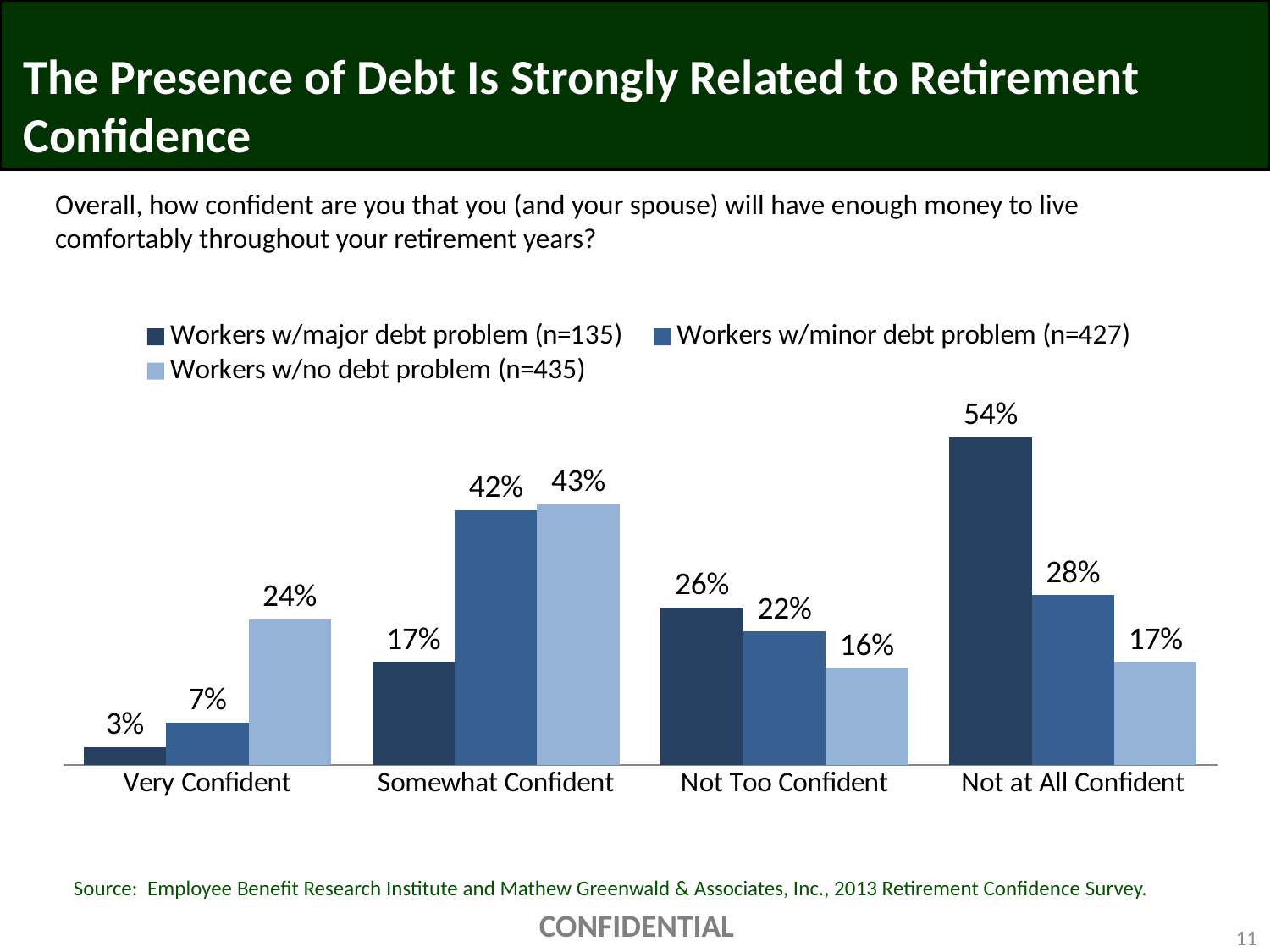
What is the difference between workers with a major debt problem and workers with no debt problem in the Not at All Confident category? 37% Do the values for workers with a major debt problem rise or fall from Very Confident to Not at All Confident? Rise How many series does the legend list? 3 Which is larger in the Not Too Confident category: workers with a major debt problem or workers with a minor debt problem? Workers w/major debt problem What kind of chart is shown on the slide? Bar chart What percentage of workers with a major debt problem are Not at All Confident? 54% What percentage of workers with a minor debt problem are Somewhat Confident? 42% Which category has the lowest value for workers with no debt problem? Not Too Confident What is the sample size (n) for workers with a minor debt problem shown in the legend? 427 How many categories are shown on the x axis? 4 What percentage of workers with no debt problem are Very Confident? 24% Which category has the highest value for workers with a major debt problem? Not at All Confident